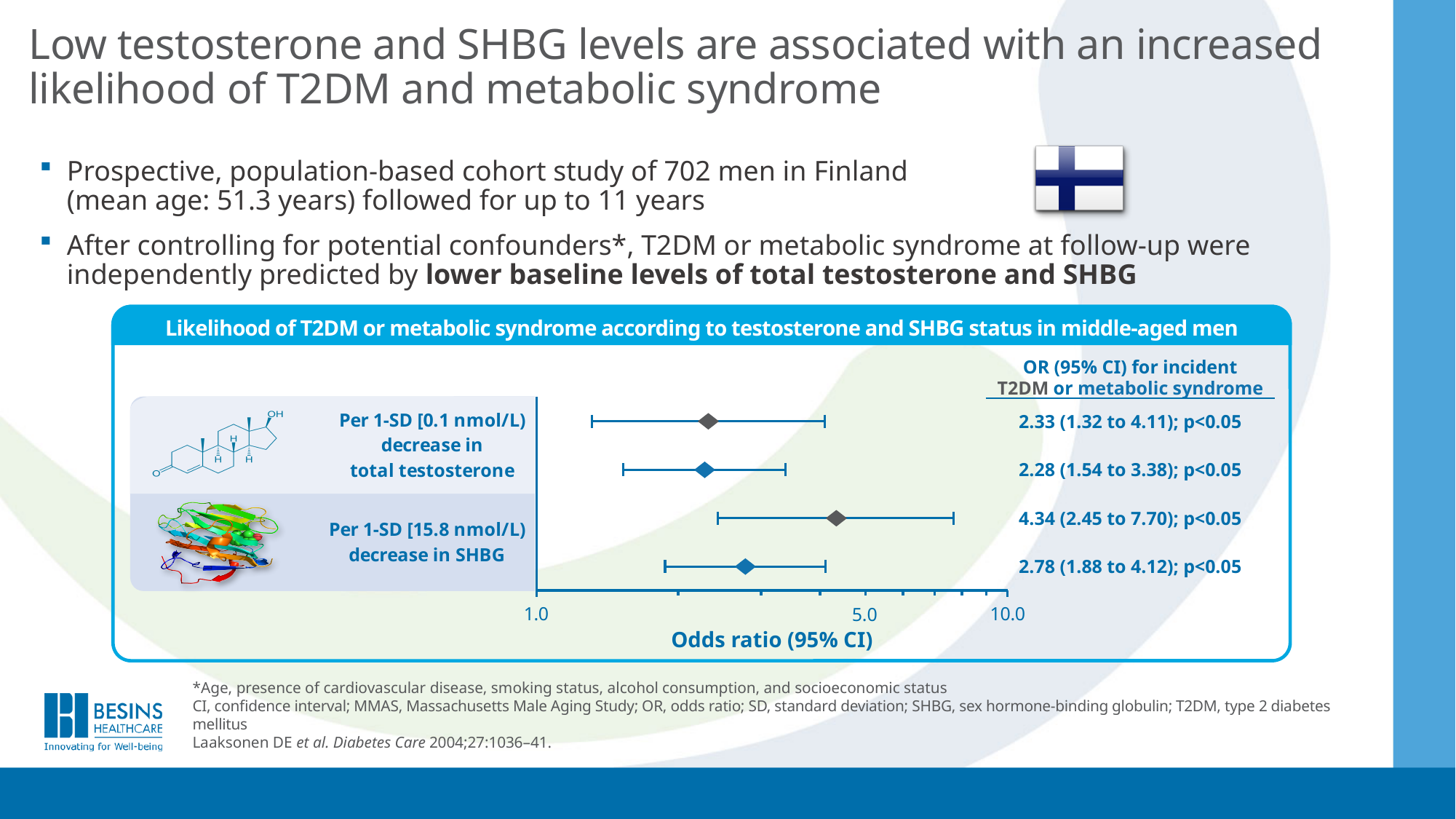
Is the odds ratio for the upper SHBG row greater or less than 5.0 on the x axis? less What is the difference between the highest odds ratio (4.34) and the lowest odds ratio (2.28) in the forest plot? 2.06 What is the odds ratio (95% CI) shown for the lower row under 'Per 1-SD [0.1 nmol/L] decrease in total testosterone'? 2.28 (1.54 to 3.38); p<0.05 What kind of chart is shown in the box titled 'Likelihood of T2DM or metabolic syndrome according to testosterone and SHBG status in middle-aged men'? Forest plot of odds ratios with 95% confidence intervals How many odds ratio estimates (points) are plotted in the forest plot? 4 What is the x-axis label of the forest plot? Odds ratio (95% CI) Which row in the forest plot has the lowest odds ratio? The lower total testosterone row (2.28) What is the odds ratio (95% CI) shown for the lower row under 'Per 1-SD [15.8 nmol/L] decrease in SHBG'? 2.78 (1.88 to 4.12); p<0.05 Which row in the forest plot has the highest odds ratio? The upper SHBG row (4.34) Which is larger: the odds ratio for the upper total testosterone row or the odds ratio for the upper SHBG row? The upper SHBG row (4.34 vs 2.33) What is the odds ratio (95% CI) shown for the upper row under 'Per 1-SD [0.1 nmol/L] decrease in total testosterone'? 2.33 (1.32 to 4.11); p<0.05 What is the odds ratio (95% CI) shown for the upper row under 'Per 1-SD [15.8 nmol/L] decrease in SHBG'? 4.34 (2.45 to 7.70); p<0.05